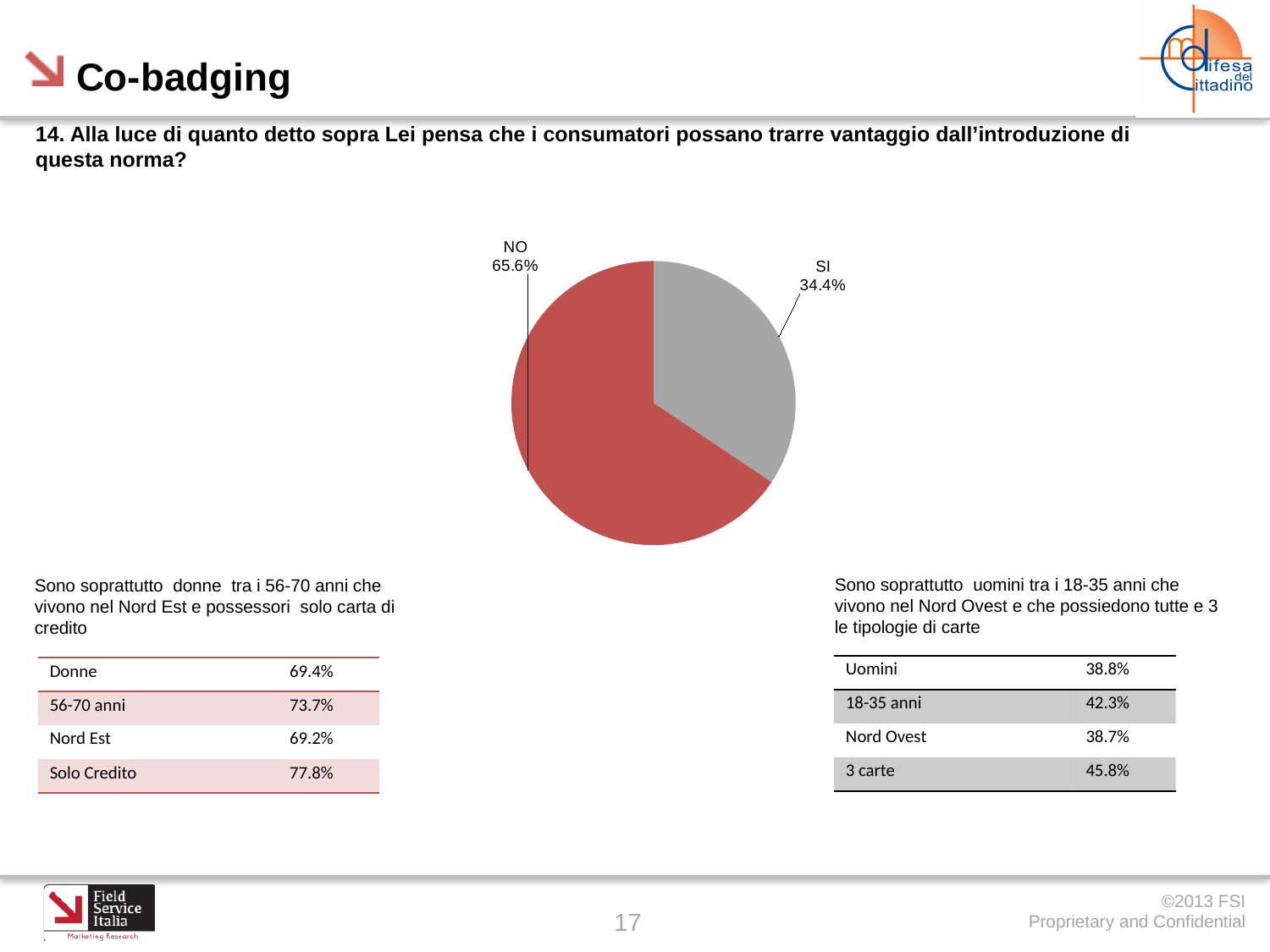
What is the value for NO in the pie chart? 65.6% What kind of chart is shown on the slide? pie chart Which slice of the pie chart is the largest? NO What share of the pie does the NO slice represent? 65.6% What colour is the NO slice in the pie chart? red Which slice of the pie chart is the smallest? SI What is the difference between the NO and SI values in the pie chart? 31.2% How many slices does the pie chart have? 2 What is the value for SI in the pie chart? 34.4% Which is larger in the pie chart, SI or NO? NO What colour is the SI slice in the pie chart? grey